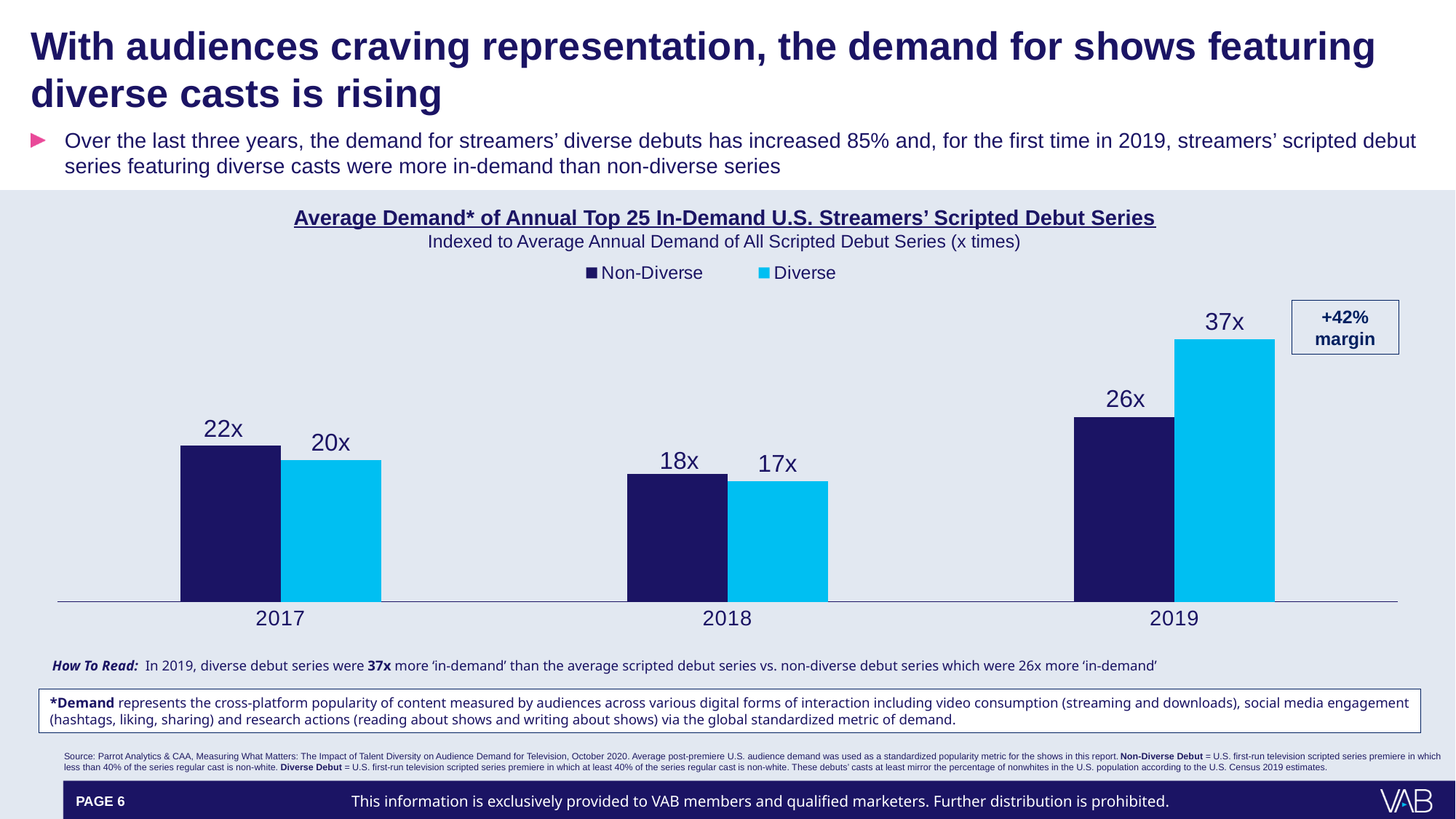
What kind of chart is shown on the slide? Bar chart What is the Diverse value for 2019? 37x What is the Non-Diverse value for 2017? 22x Does the Diverse value rise or fall from 2018 to 2019? Rise What margin is shown in the box next to the 2019 bars? +42% margin Which year has the highest Non-Diverse value? 2019 How many series does the legend list? 2 In 2017, which is larger: the Non-Diverse value or the Diverse value? Non-Diverse What is the difference between the Diverse and Non-Diverse values in 2019? 11x What is the Diverse value for 2018? 17x How many years are shown on the x axis? 3 Which year has the lowest Diverse value? 2018